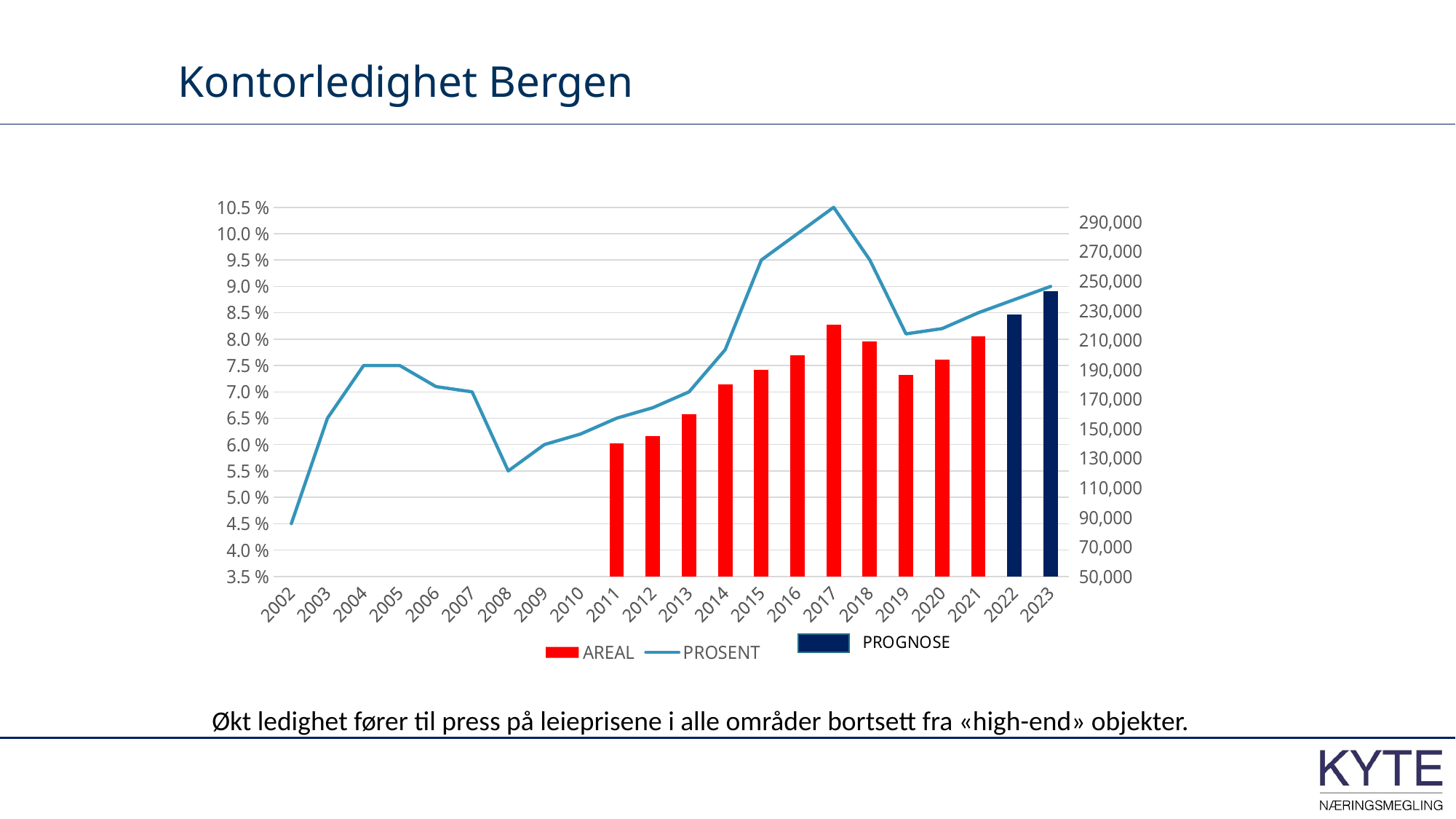
Which year has the shortest AREAL (red) bar? 2011 What is the title of the chart? Kontorledighet Bergen Is the AREAL value for 2011 greater or less than 150,000? less How many years are shown on the x axis? 22 In which year does the PROSENT line reach its highest value? 2017 What kind of chart is shown on the slide? A combined bar and line chart In which year is the PROSENT line at its lowest value? 2002 How many series does the legend list? 3 Which year has the tallest AREAL (red) bar? 2017 Is the PROGNOSE value for 2023 greater or less than 230,000? greater Which year has the higher PROSENT value, 2015 or 2019? 2015 Is the PROSENT value for 2008 greater or less than 6.0 %? less